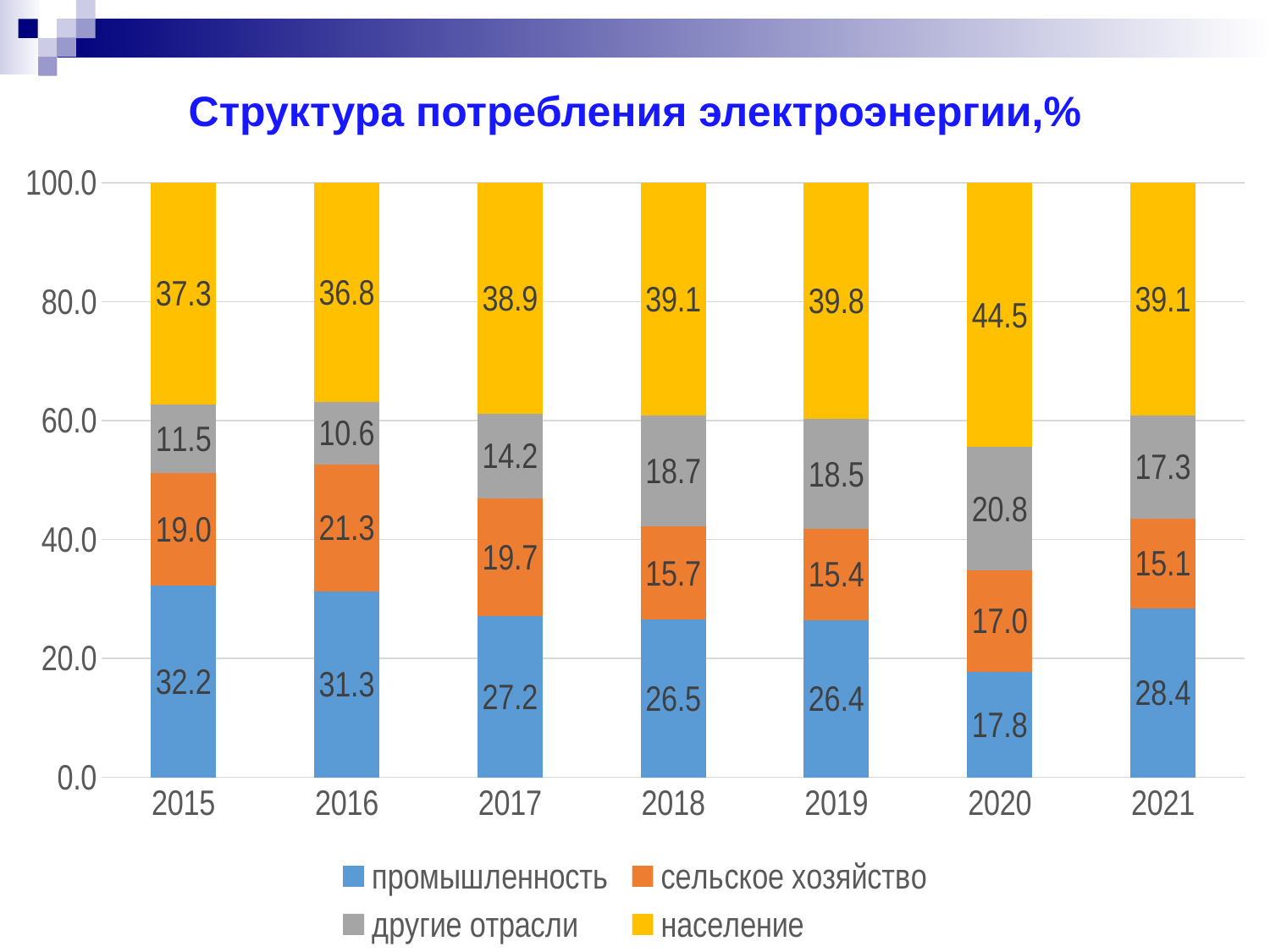
What is the value for другие отрасли in 2018? 18.7 What is the difference between the value for население in 2020 and in 2015? 7.2 How many series does the legend list? 4 How many years are shown on the x axis? 7 In which year is the value for промышленность the lowest? 2020 From 2017 to 2020, does the value for население rise or fall? rise What kind of chart is shown on the slide? stacked bar chart What is the value for сельское хозяйство in 2021? 15.1 Which is larger: the value for сельское хозяйство in 2016 or in 2017? 2016 What is the value for население in 2020? 44.5 In which year is the value for население the highest? 2020 What is the value for промышленность in 2015? 32.2